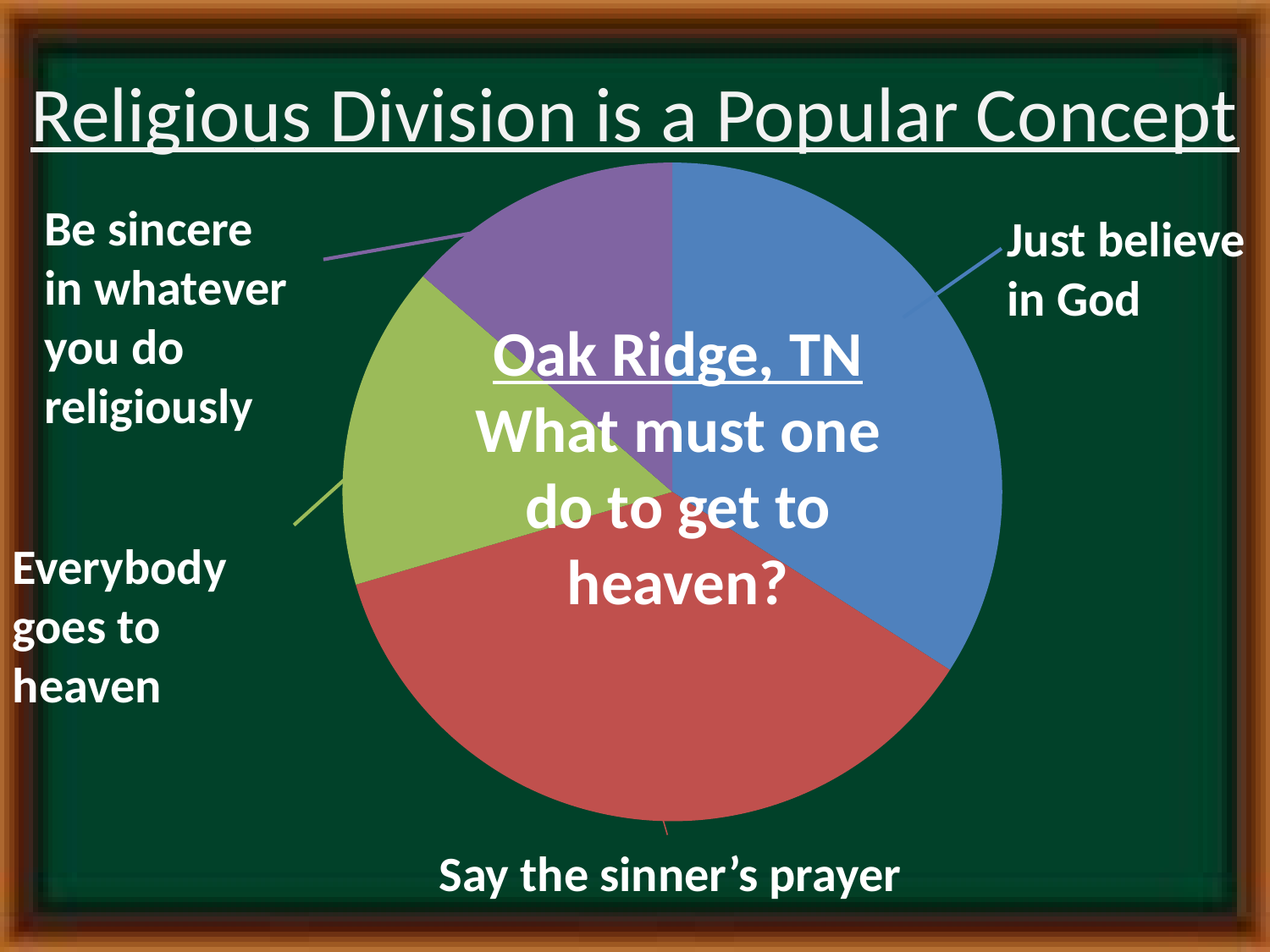
Which city is named in the pie chart's title? Oak Ridge, TN What kind of chart is shown on the slide? pie chart Which slice is larger: "Say the sinner's prayer" or "Be sincere in whatever you do religiously"? Say the sinner's prayer Which slice is larger: "Just believe in God" or "Everybody goes to heaven"? Just believe in God Which slice is larger: "Just believe in God" or "Be sincere in whatever you do religiously"? Just believe in God What question does the pie chart's title ask? What must one do to get to heaven? How many slices does the pie chart have? 4